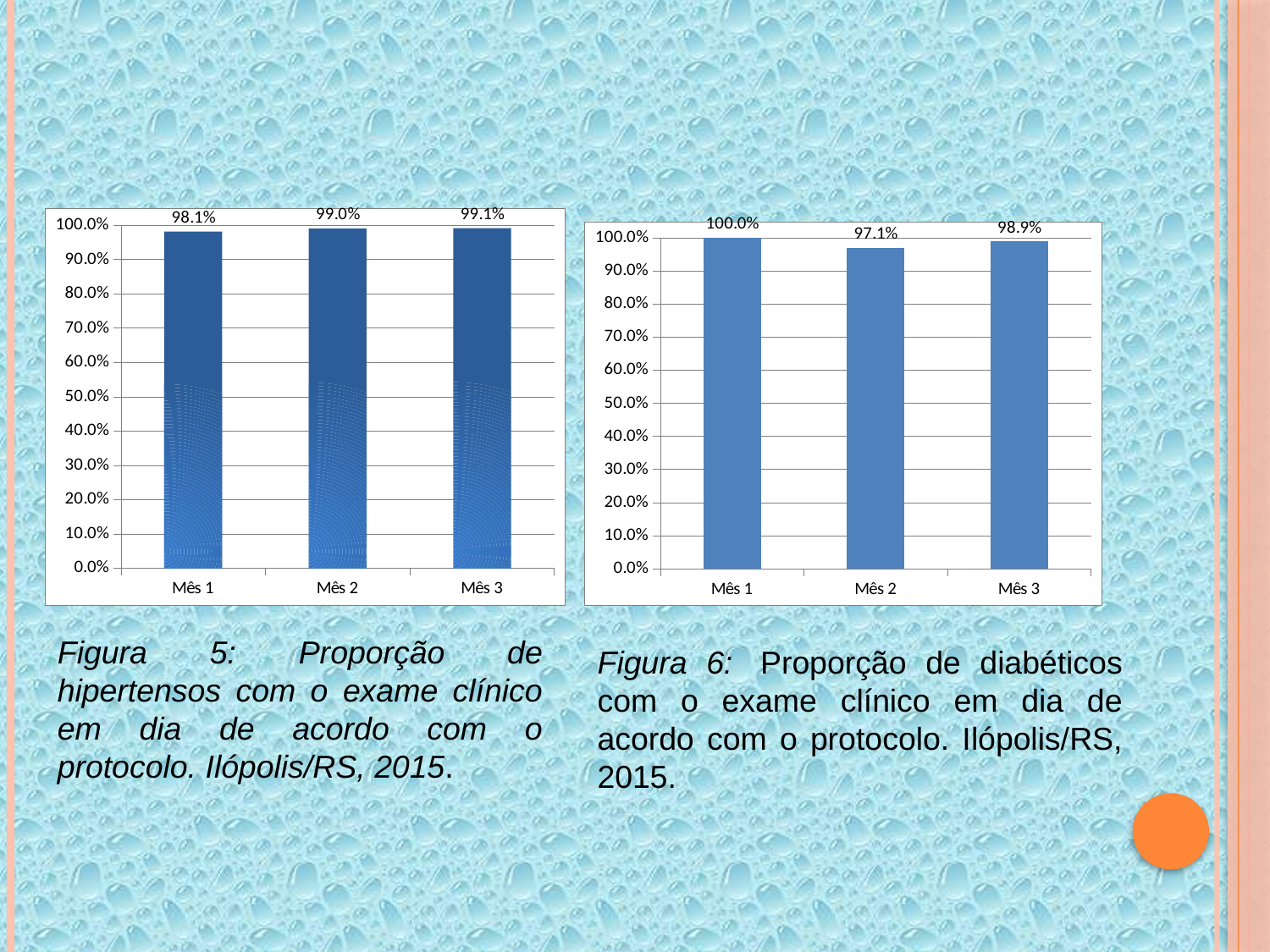
In the left chart (Figura 5, hipertensos), what is the value for Mês 3? 99.1% In the left chart (Figura 5, hipertensos), what is the difference between the values for Mês 3 and Mês 1? 1.0% In the left chart (Figura 5, hipertensos), how many months are shown on the x axis? 3 In the left chart (Figura 5, hipertensos), do the values rise or fall from Mês 1 to Mês 3? Rise What kind of chart is the right chart (Figura 6, diabéticos)? Bar chart In the right chart (Figura 6, diabéticos), what is the value for Mês 1? 100.0% In the right chart (Figura 6, diabéticos), what is the difference between the values for Mês 1 and Mês 2? 2.9% In the right chart (Figura 6, diabéticos), what is the value for Mês 2? 97.1% In the left chart (Figura 5, hipertensos), which month has the lowest value? Mês 1 In the left chart (Figura 5, hipertensos), what is the value for Mês 1? 98.1% In the right chart (Figura 6, diabéticos), which month has the highest value? Mês 1 In the right chart (Figura 6, diabéticos), which month has the lowest value? Mês 2